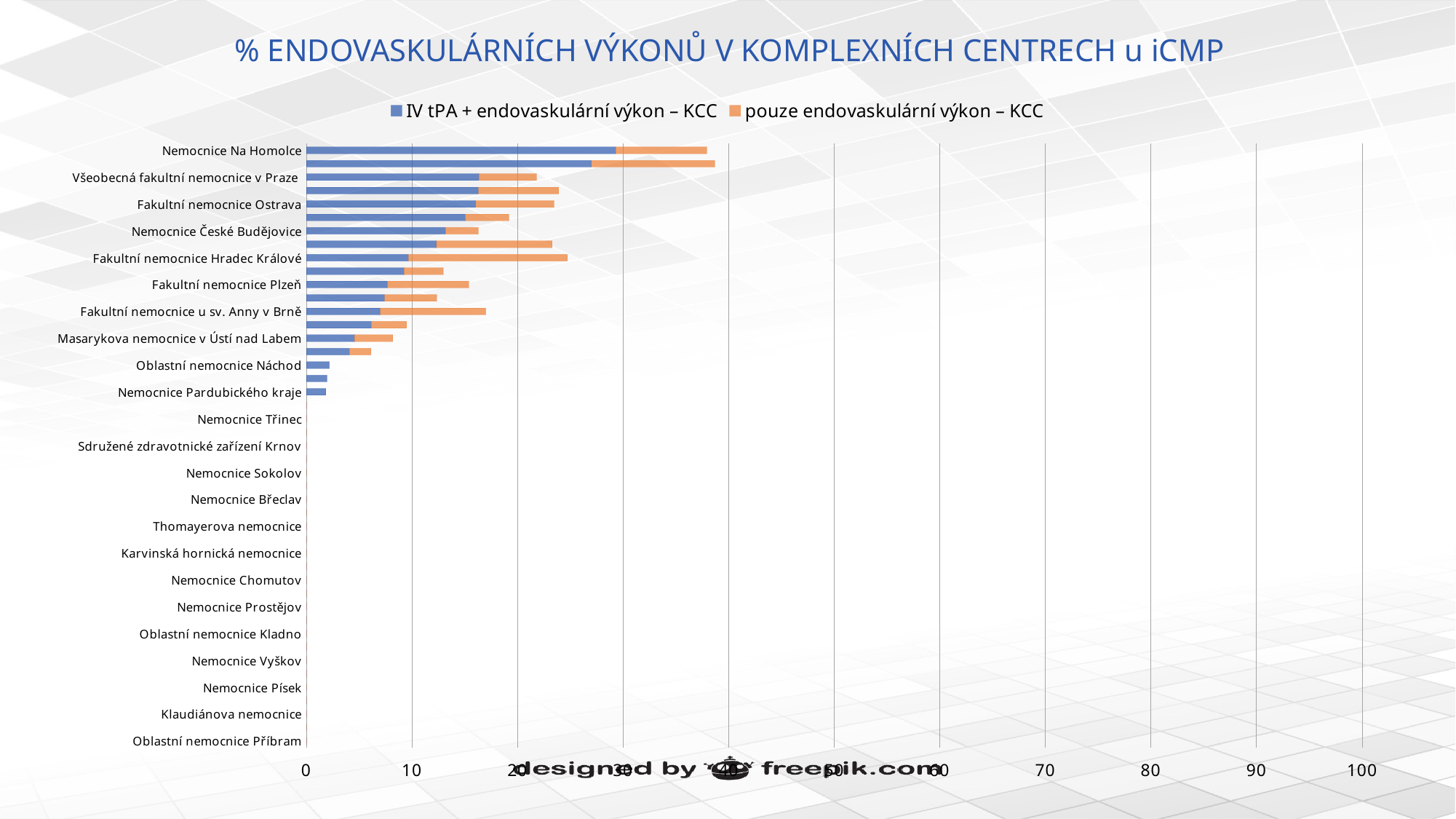
Is the total value for Oblastní nemocnice Náchod greater or less than 10? less Do the bar lengths generally increase or decrease going down the list of hospitals? decrease Is the total value for Masarykova nemocnice v Ústí nad Labem greater or less than 10? less Which has the larger total value, Fakultní nemocnice Ostrava or Nemocnice České Budějovice? Fakultní nemocnice Ostrava Is the total value for Fakultní nemocnice Hradec Králové greater or less than 20? greater Which has the larger total value, Nemocnice Na Homolce or Fakultní nemocnice Hradec Králové? Nemocnice Na Homolce What is the title of the chart? % ENDOVASKULÁRNÍCH VÝKONŮ V KOMPLEXNÍCH CENTRECH u iCMP Which colour represents the series "pouze endovaskulární výkon – KCC"? orange How many series does the legend list? 2 What kind of chart is shown on the slide? bar chart